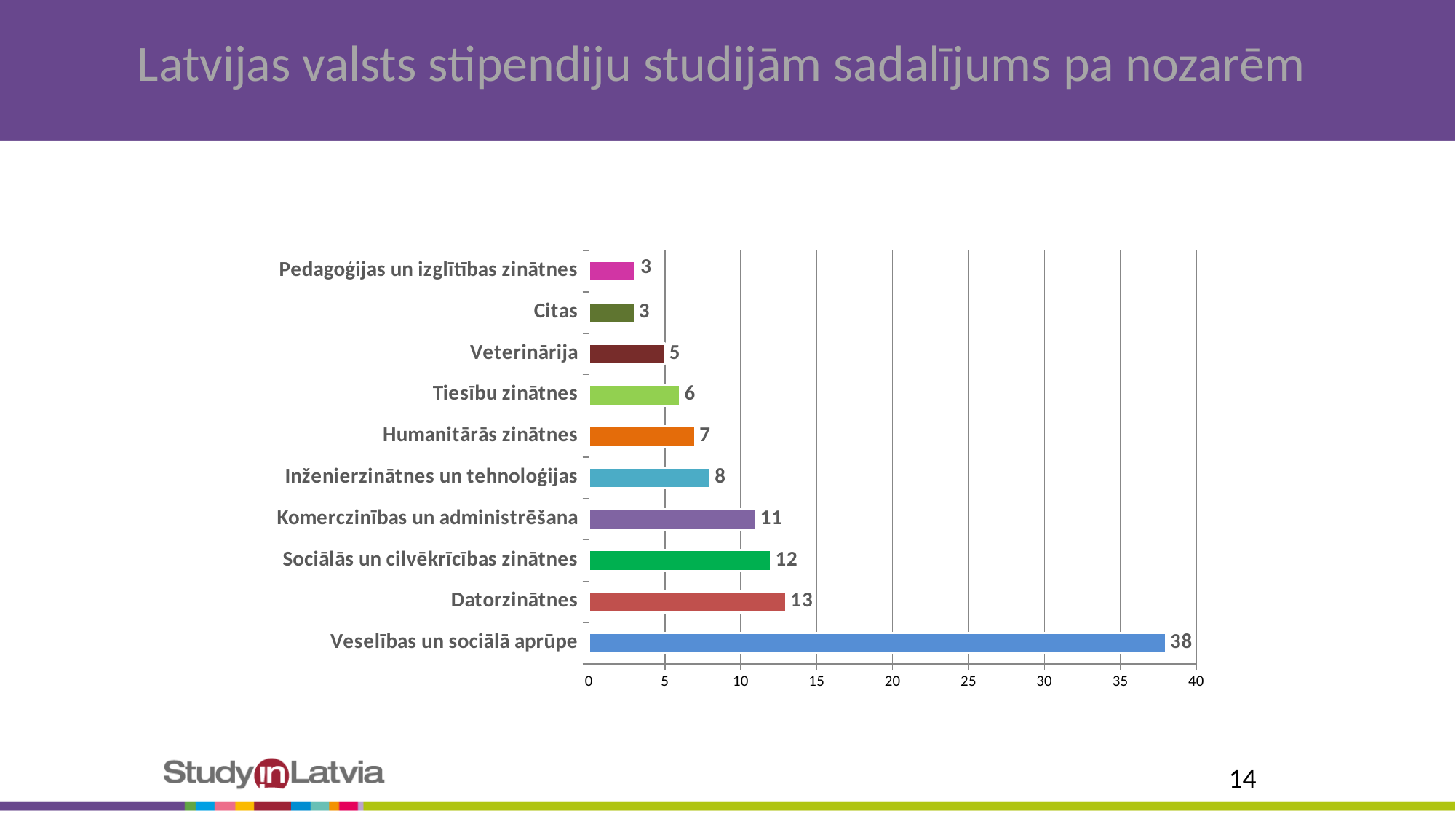
What is the value for Inženierzinātnes un tehnoloģijas? 8 What is the value for Datorzinātnes? 13 What is the difference between the values for Sociālās un cilvēkrīcības zinātnes and Humanitārās zinātnes? 5 Which is larger, the value for Komerczinības un administrēšana or the value for Tiesību zinātnes? Komerczinības un administrēšana What is the difference between the values for Veselības un sociālā aprūpe and Datorzinātnes? 25 What is the value for Veselības un sociālā aprūpe? 38 Which category has the highest value? Veselības un sociālā aprūpe What kind of chart is shown on the slide? bar chart What is the title of the slide? Latvijas valsts stipendiju studijām sadalījums pa nozarēm Is the value for Veselības un sociālā aprūpe greater or less than 35? greater How many categories are shown in the chart? 10 What is the value for Veterinārija? 5